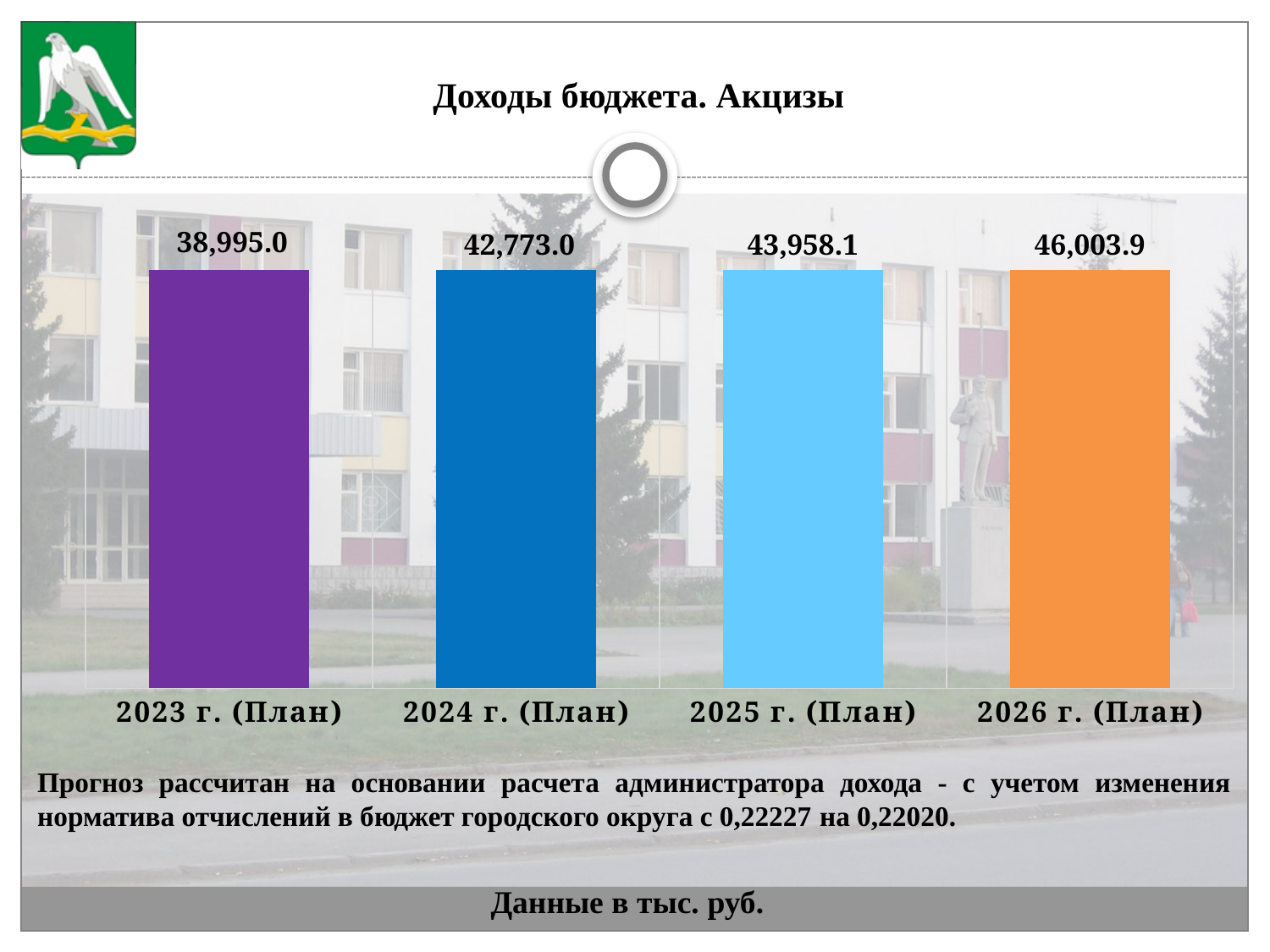
What is the value for 2024 г. (План)? 42,773.0 Which is larger, the value for 2025 г. (План) or 2024 г. (План)? 2025 г. (План) Which year has the lowest value? 2023 г. (План) Do the values rise or fall from 2023 to 2026? Rise Which year has the highest value? 2026 г. (План) What is the difference between the values for 2024 г. (План) and 2023 г. (План)? 3,778.0 What is the value for 2025 г. (План)? 43,958.1 What is the difference between the values for 2026 г. (План) and 2023 г. (План)? 7,008.9 What kind of chart is shown on the slide? Bar chart What is the value for 2023 г. (План)? 38,995.0 How many categories are shown in the chart? 4 What is the value for 2026 г. (План)? 46,003.9